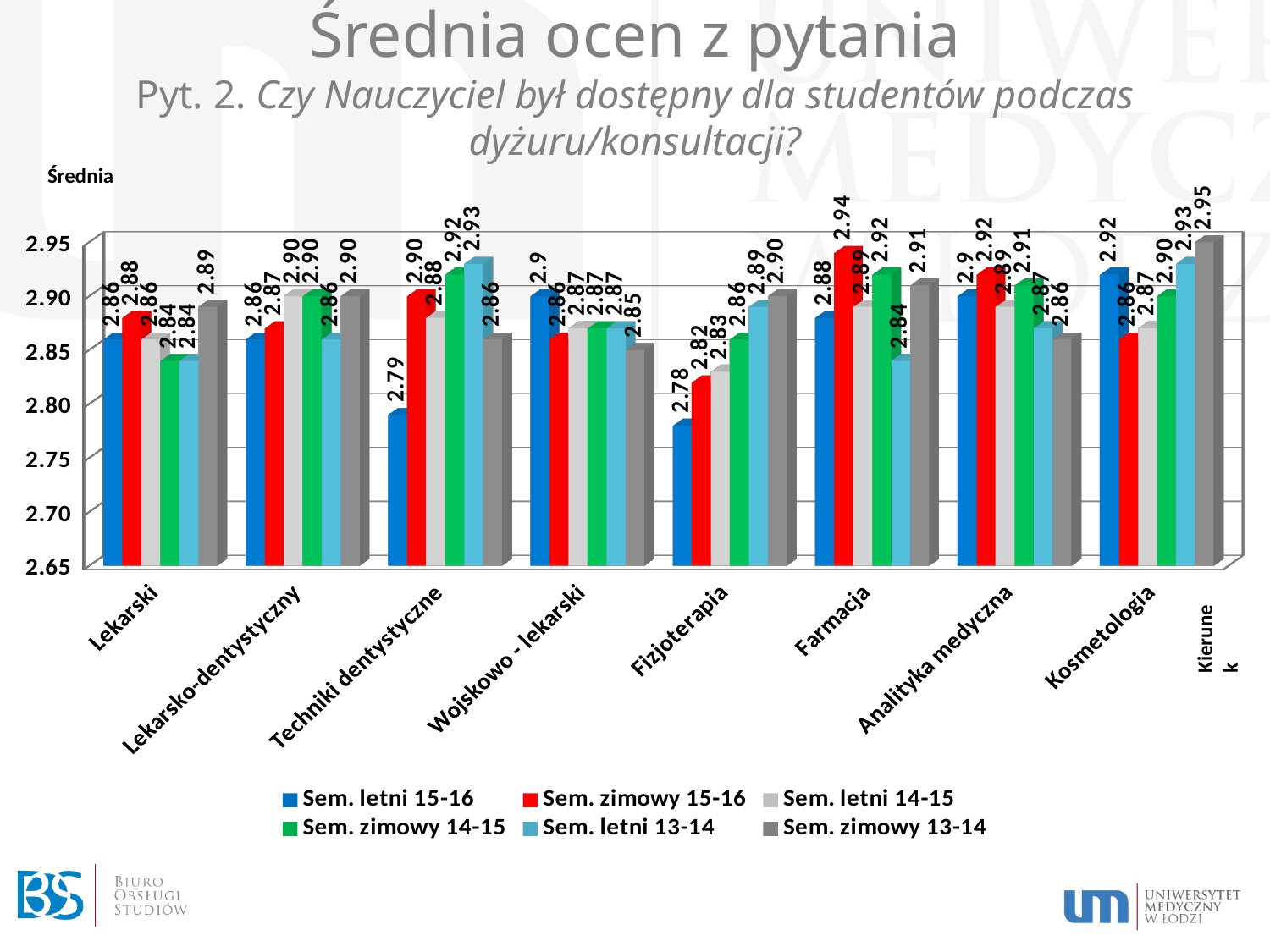
What is the value for Kosmetologia in Sem. zimowy 13-14? 2.95 Which programme has the highest value in the Sem. zimowy 15-16 series? Farmacja What is the value for Techniki dentystyczne in Sem. letni 15-16? 2.79 What type of chart is shown on the slide? bar chart Which programme has the lowest value in the Sem. letni 15-16 series? Fizjoterapia What is the value for Fizjoterapia in Sem. letni 15-16? 2.78 What is the value for Farmacja in Sem. zimowy 15-16? 2.94 What is the label of the vertical axis? Średnia What is the difference between the Sem. zimowy 13-14 and Sem. letni 15-16 values for Fizjoterapia? 0.12 How many study programmes (categories) are shown on the x axis? 8 How many series does the legend list? 6 For Farmacja, which is larger: the Sem. zimowy 15-16 value or the Sem. letni 13-14 value? Sem. zimowy 15-16